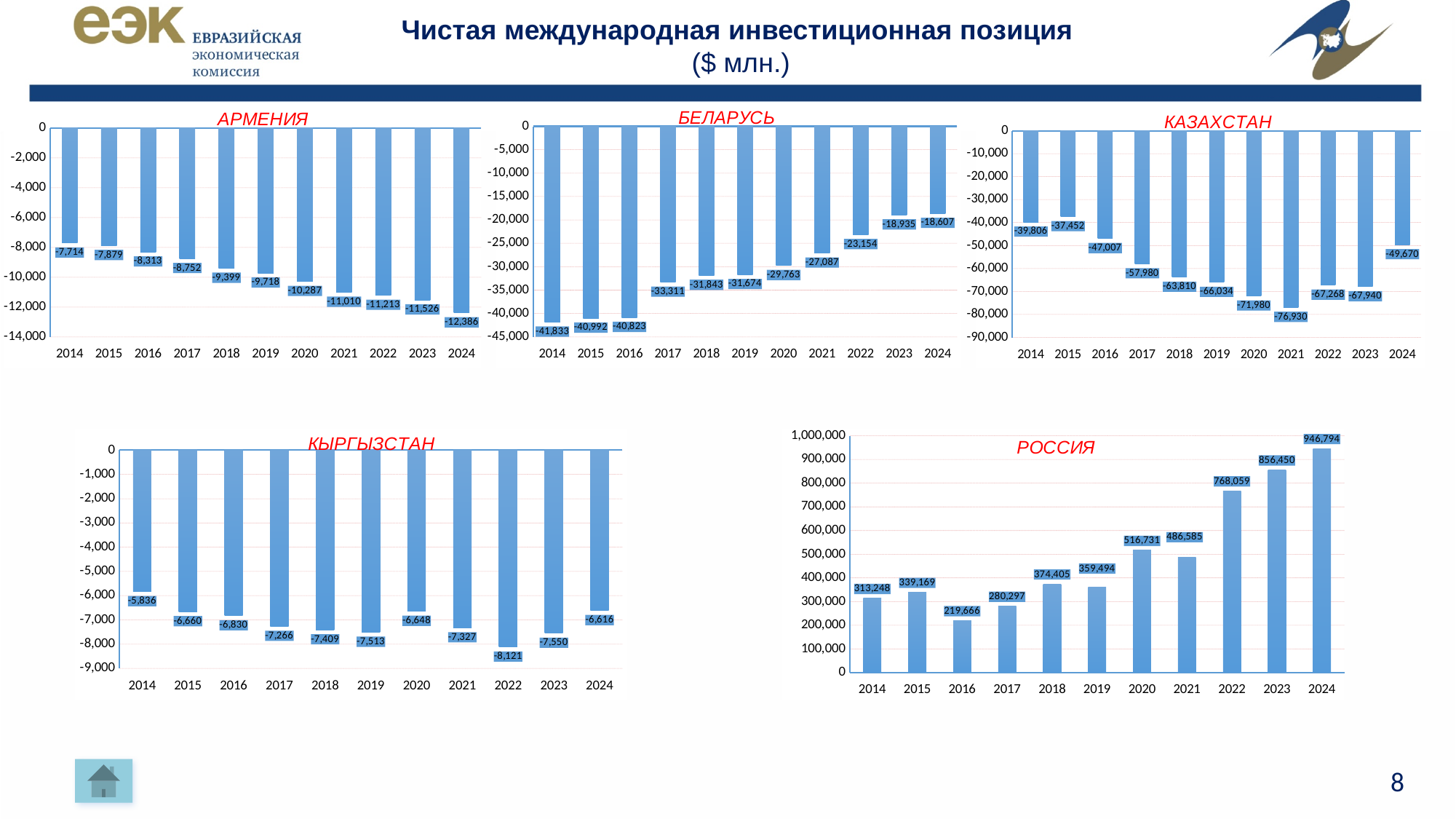
On the КАЗАХСТАН chart, which value is larger (less negative): 2015 or 2016? 2015 On the КЫРГЫЗСТАН chart, which year has the most negative value? 2022 On the РОССИЯ chart, which year has the highest value? 2024 On the АРМЕНИЯ chart, what is the value for 2024? -12,386 On the АРМЕНИЯ chart, do the values rise or fall from 2014 to 2024? Fall How many years are shown on the АРМЕНИЯ chart? 11 What kind of chart is the РОССИЯ chart? Bar chart On the РОССИЯ chart, which year has the lowest value? 2016 On the БЕЛАРУСЬ chart, what is the value for 2017? -33,311 On the КАЗАХСТАН chart, which year has the lowest (most negative) value? 2021 On the БЕЛАРУСЬ chart, what is the difference between the 2014 and 2024 values? 23,226 On the РОССИЯ chart, what is the difference between the 2024 and 2023 values? 90,344